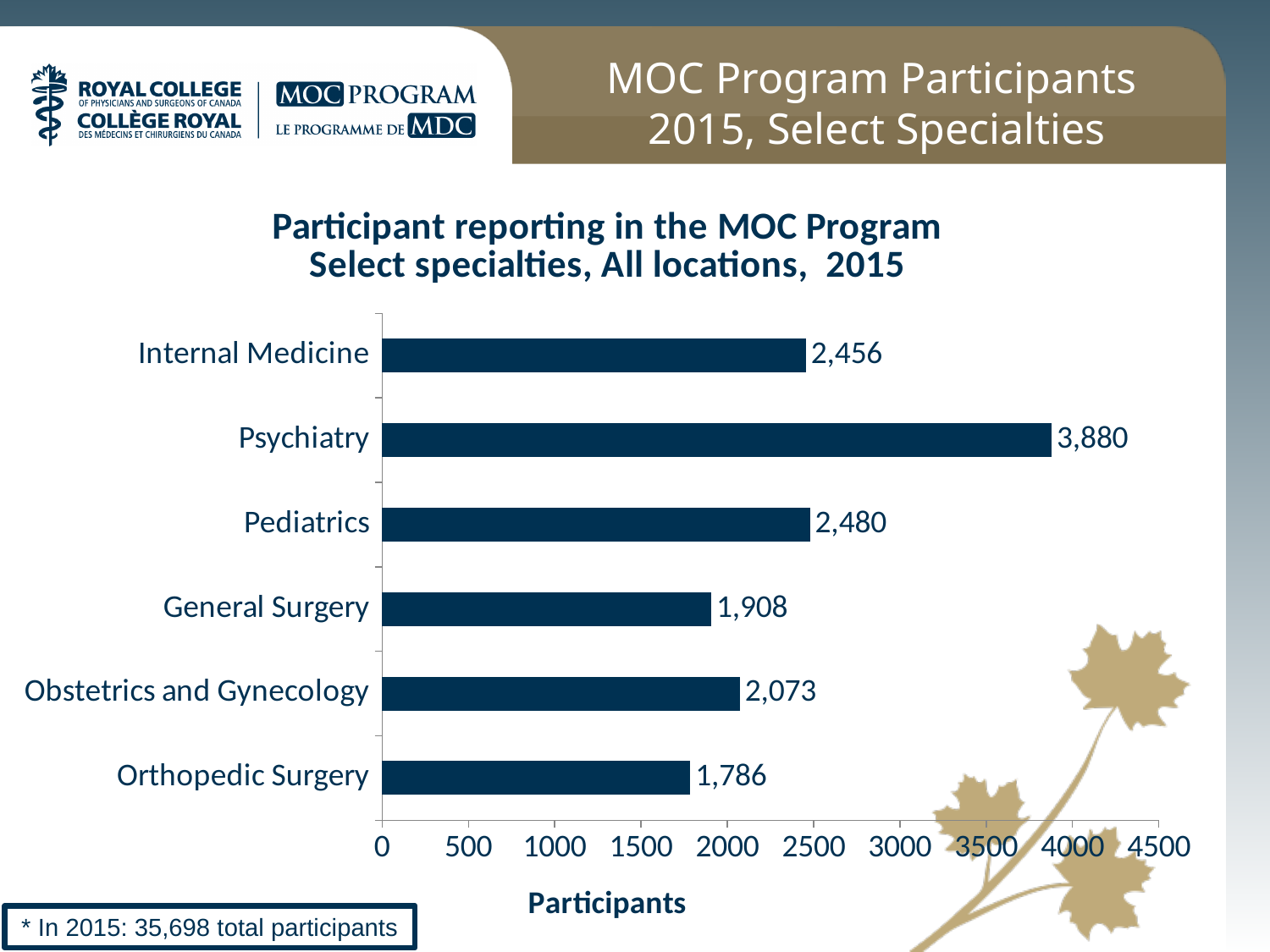
Which has more participants, Pediatrics or Internal Medicine? Pediatrics What is the label of the horizontal axis? Participants How many participants are shown for Obstetrics and Gynecology? 2,073 What is the difference between General Surgery and Orthopedic Surgery? 122 Is the value for General Surgery greater or less than 2000? less Which specialty has the lowest number of participants? Orthopedic Surgery What kind of chart is shown on the slide? Bar chart How many participants does the chart show for Psychiatry? 3,880 Which specialty has the highest number of participants? Psychiatry What is the value for Orthopedic Surgery? 1,786 What is the difference in participants between Psychiatry and Internal Medicine? 1,424 How many specialties are shown in the chart? 6